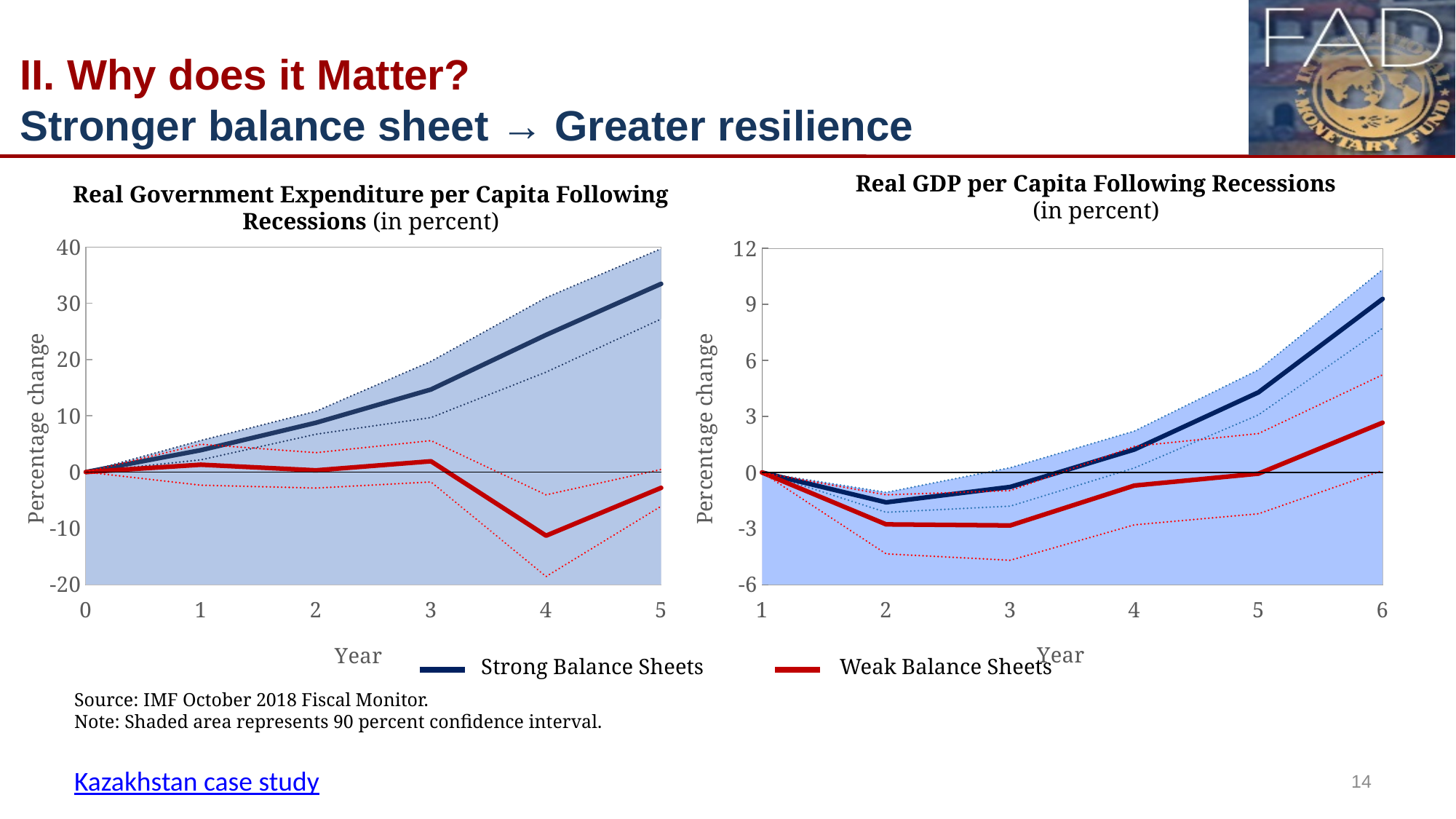
In the 'Real GDP per Capita Following Recessions' chart, how many year points are labelled on the x axis? 6 In the 'Real Government Expenditure per Capita Following Recessions' chart, which series has the larger value at year 5, Strong Balance Sheets or Weak Balance Sheets? Strong Balance Sheets In the 'Real GDP per Capita Following Recessions' chart, is the value for Strong Balance Sheets at year 6 greater or less than 6? greater In the 'Real GDP per Capita Following Recessions' chart, is the value for Weak Balance Sheets at year 6 greater or less than 0? greater What colour is the Weak Balance Sheets line in the charts? red In the 'Real Government Expenditure per Capita Following Recessions' chart, is the value for Strong Balance Sheets at year 5 greater or less than 30? greater How many series does the shared legend list for the charts? 2 In the 'Real GDP per Capita Following Recessions' chart, which series has the larger value at year 6, Strong Balance Sheets or Weak Balance Sheets? Strong Balance Sheets What kind of chart is the 'Real Government Expenditure per Capita Following Recessions' chart on the left? line chart In the 'Real Government Expenditure per Capita Following Recessions' chart, does the Strong Balance Sheets line rise or fall from year 0 to year 5? rise